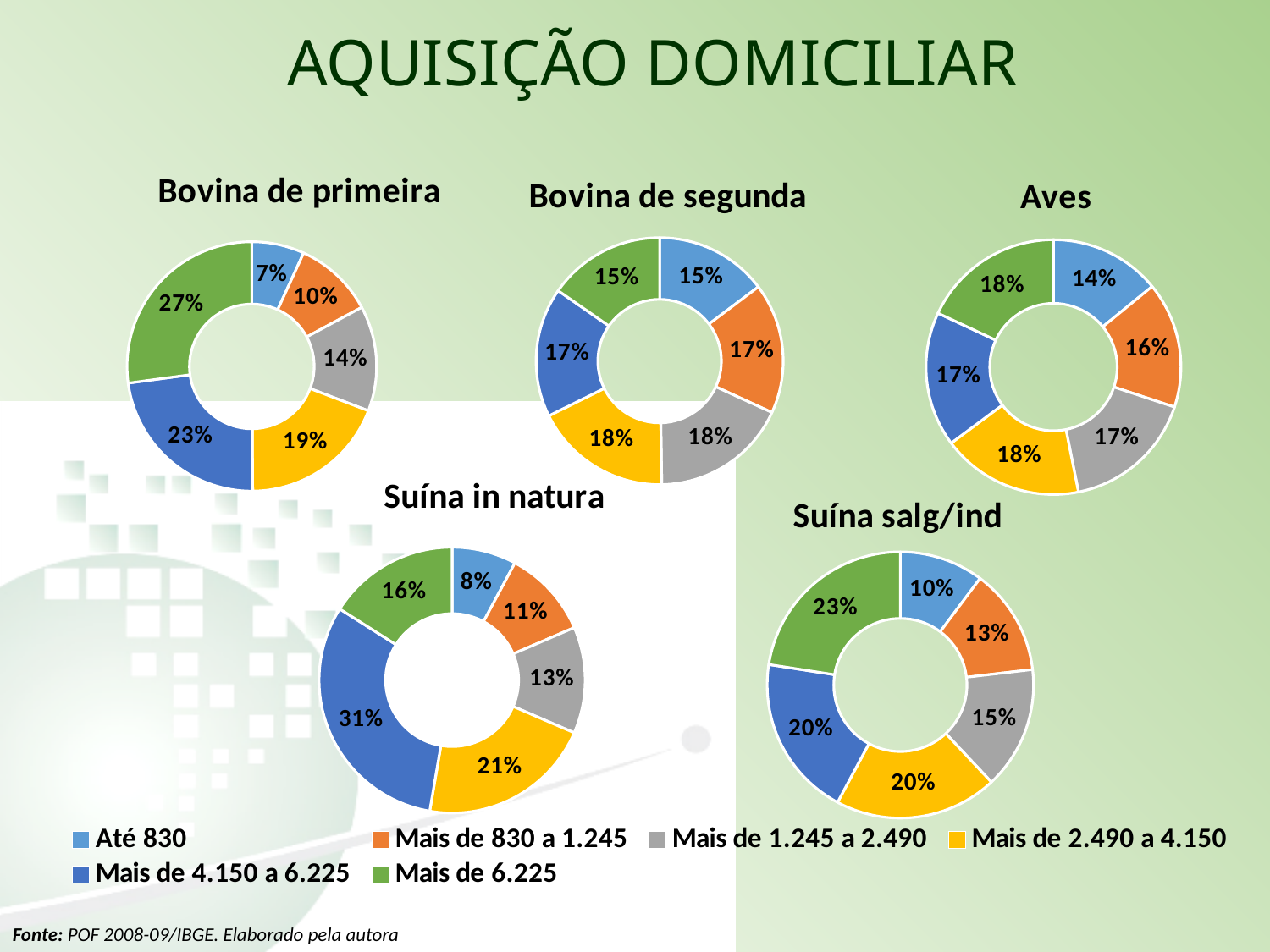
In the 'Suína in natura' chart, what share is shown for the 'Mais de 4.150 a 6.225' category? 31% How many categories does the legend list? 6 How many charts are shown on the slide? 5 In the 'Suína salg/ind' chart, which category has the largest share? Mais de 6.225 What is the title of the chart in the top-right position of the slide? Aves In the 'Suína in natura' chart, what is the difference between the shares for 'Mais de 4.150 a 6.225' and 'Até 830'? 23 percentage points What kind of chart is 'Aves'? Doughnut chart In the 'Aves' chart, what share is shown for the 'Até 830' category? 14% In the 'Bovina de primeira' chart, which category has the smallest share? Até 830 In the 'Suína salg/ind' chart, what share is shown for the 'Mais de 1.245 a 2.490' category? 15% In the 'Bovina de segunda' chart, which is larger: the share for 'Mais de 1.245 a 2.490' or the share for 'Até 830'? Mais de 1.245 a 2.490 In the 'Bovina de primeira' chart, what share is shown for the 'Mais de 6.225' category? 27%